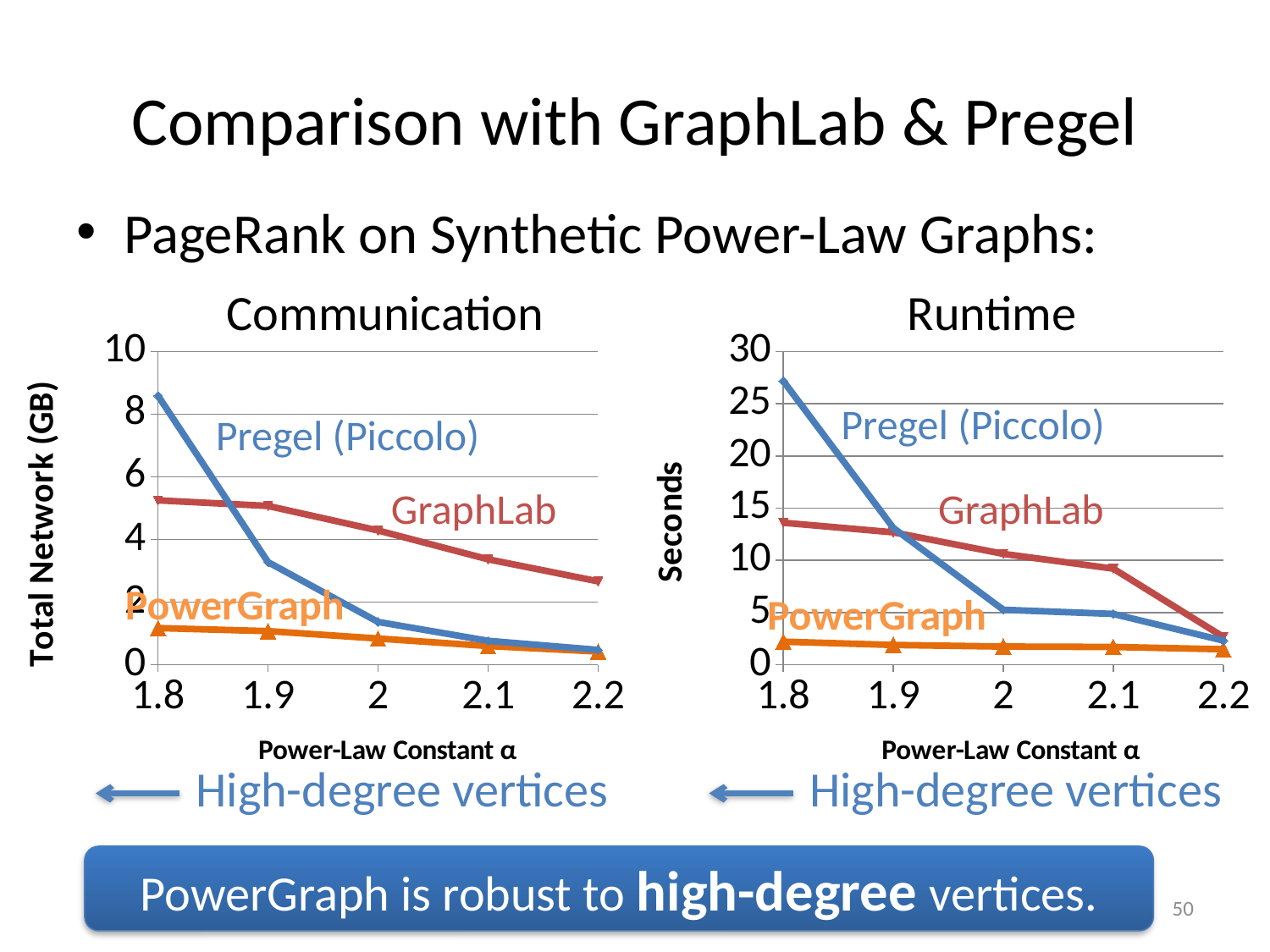
On the Communication chart, is the value for PowerGraph at α = 1.8 greater or less than 2? less What kind of chart is the Communication chart? line chart On the Runtime chart, is the value for GraphLab at α = 1.8 greater or less than 15? less On the Communication chart, which series has the lowest value at α = 1.8? PowerGraph How many x-axis points (power-law constant values) are plotted on the Runtime chart? 5 On the Runtime chart, is the value for Pregel (Piccolo) at α = 1.8 greater or less than 25? greater On the Communication chart, does the Pregel (Piccolo) line rise or fall as the power-law constant α increases? fall On the Runtime chart, which is larger at α = 2.1: GraphLab or PowerGraph? GraphLab What is the y-axis label of the Runtime chart? Seconds On the Runtime chart, which series has the highest value at α = 1.8? Pregel (Piccolo) On the Communication chart, which series has the highest value at α = 1.8? Pregel (Piccolo)